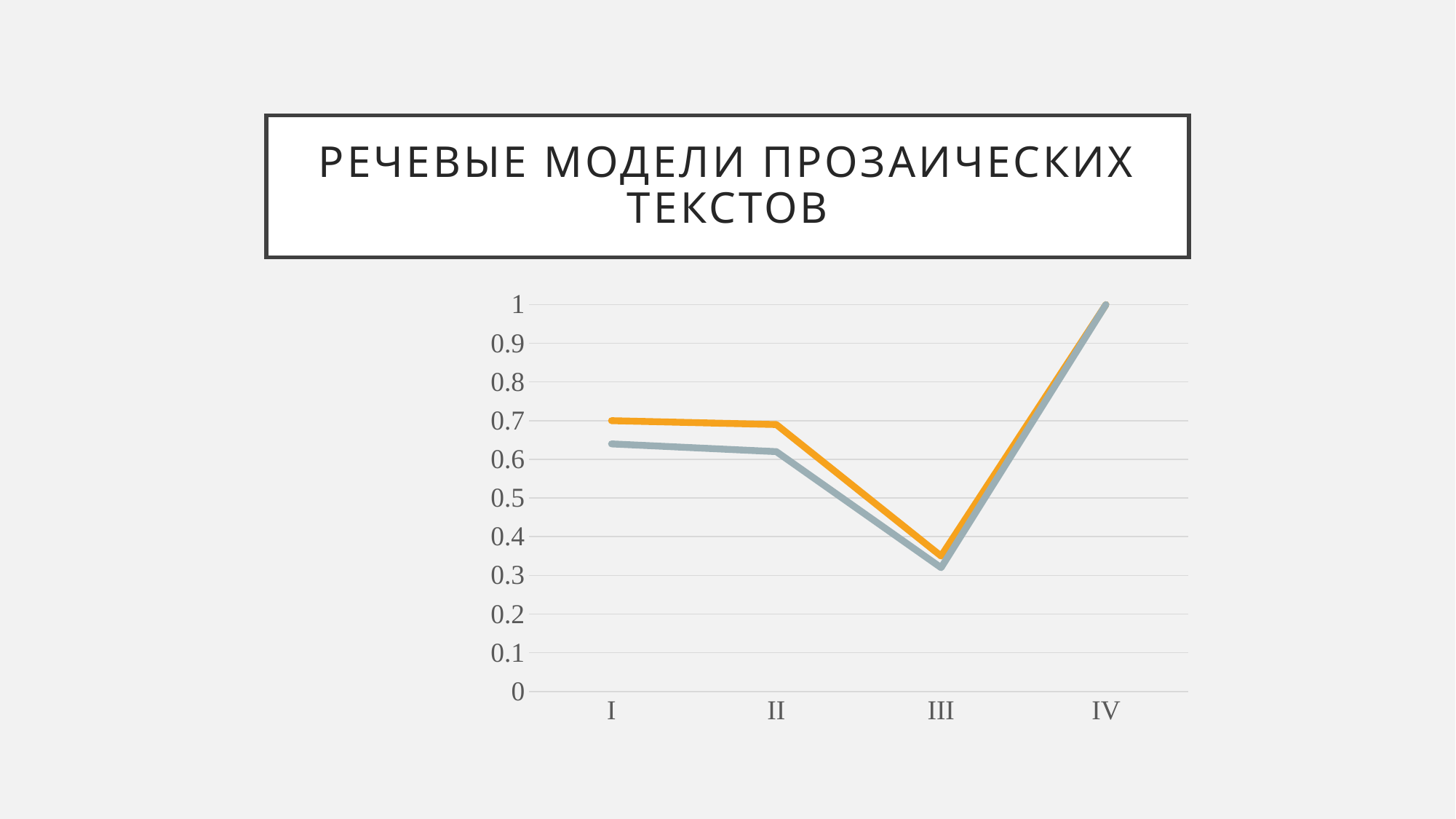
What is the title of the slide containing the chart? РЕЧЕВЫЕ МОДЕЛИ ПРОЗАИЧЕСКИХ ТЕКСТОВ Is the value of the grey line at category III greater or less than 0.4? less Do the lines rise or fall from category II to category III? fall At which category does the grey line reach its highest value? IV At which category does the orange line reach its lowest value? III At category I, which line has the larger value, the orange line or the grey line? the orange line How many categories are shown on the x axis of the chart? 4 What value do both lines reach at category IV? 1 How many lines are plotted on the chart? 2 Is the value of the orange line at category II greater or less than 0.6? greater What kind of chart is shown on the slide? line chart Is the value of the grey line at category I greater or less than 0.7? less